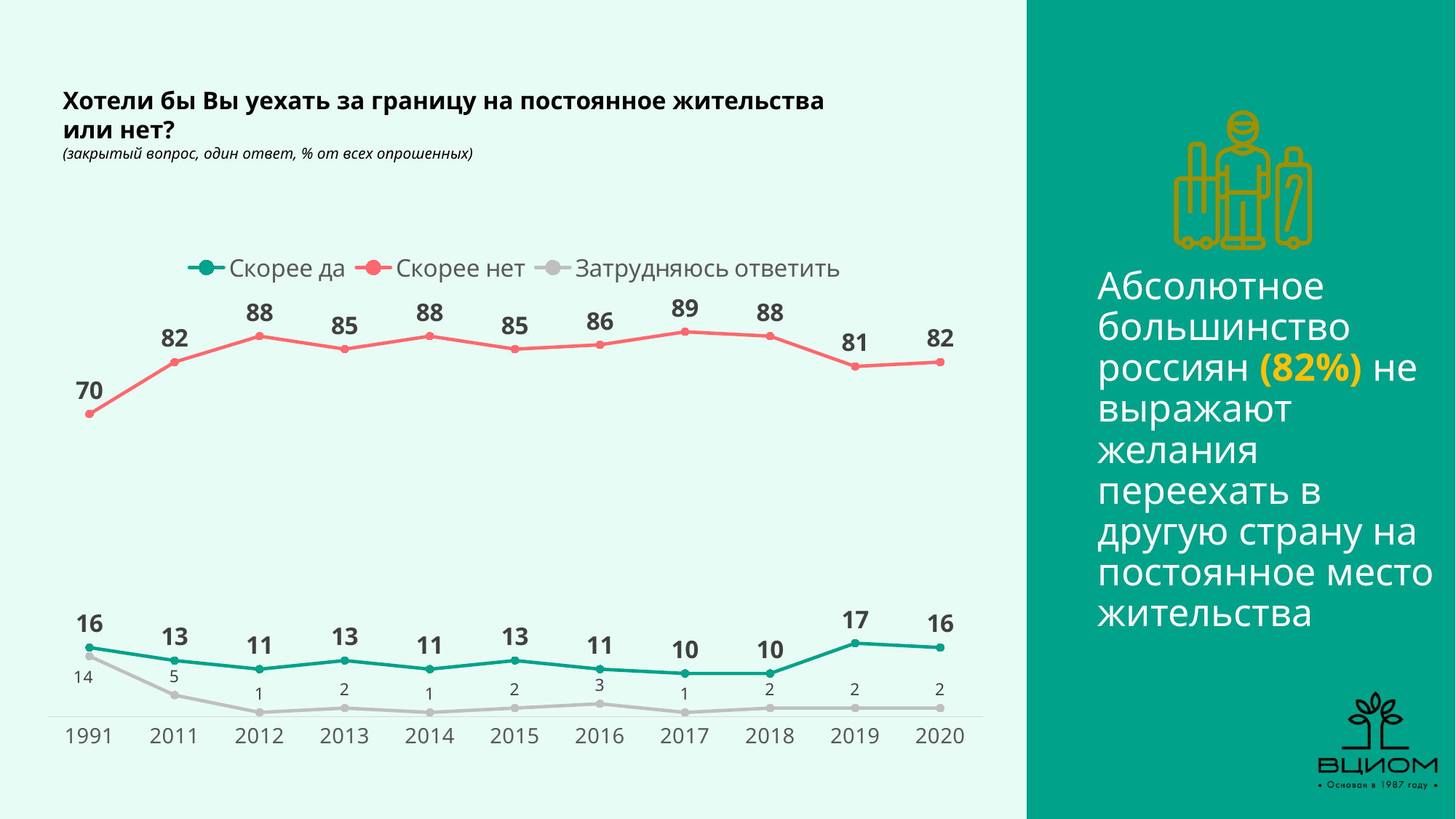
Which is larger in 2011: the value for "Скорее да" or the value for "Затрудняюсь ответить"? Скорее да What type of chart is shown on the slide? line chart What is the difference between the "Скорее нет" values in 2012 and 2020? 6 How many series does the legend list? 3 Does the value for "Скорее нет" rise or fall from 1991 to 2012? rise What is the value for "Скорее нет" in 2017? 89 In which year is the value for "Скорее нет" the highest? 2017 In which year is the value for "Скорее нет" the lowest? 1991 How many years are shown on the x axis? 11 What is the value for "Затрудняюсь ответить" in 1991? 14 What is the value for "Скорее да" in 2019? 17 Which series is drawn in red? Скорее нет